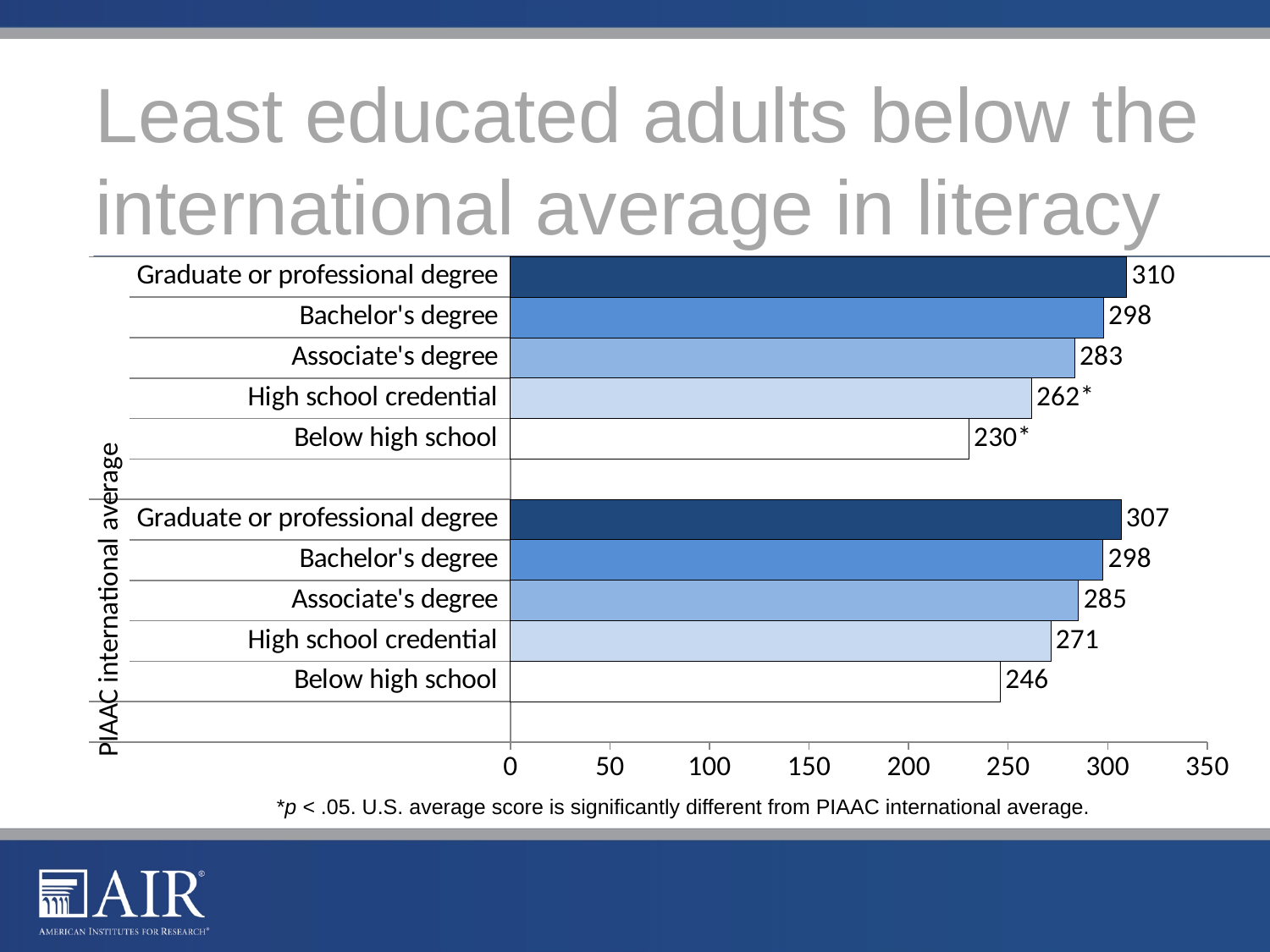
How many bars are plotted in the chart in total? 10 What does the asterisk next to some values indicate, according to the note below the chart? p < .05. U.S. average score is significantly different from PIAAC international average. What is the difference between the High school credential value in the PIAAC international average group (271) and in the upper group (262)? 9 Which is larger: the Associate's degree value in the upper group or the Associate's degree value in the PIAAC international average group? PIAAC international average group In the upper group of bars, what is the value for Associate's degree? 283 Which category has the lowest value in the upper group of bars? Below high school Which category has the highest value in the PIAAC international average group? Graduate or professional degree In the upper group of bars, what is the value for Graduate or professional degree? 310 What is the difference between the Below high school value in the PIAAC international average group (246) and the Below high school value in the upper group (230)? 16 What type of chart is shown on the slide? bar chart In the PIAAC international average group, what is the value for Below high school? 246 In the PIAAC international average group, what is the value for Graduate or professional degree? 307